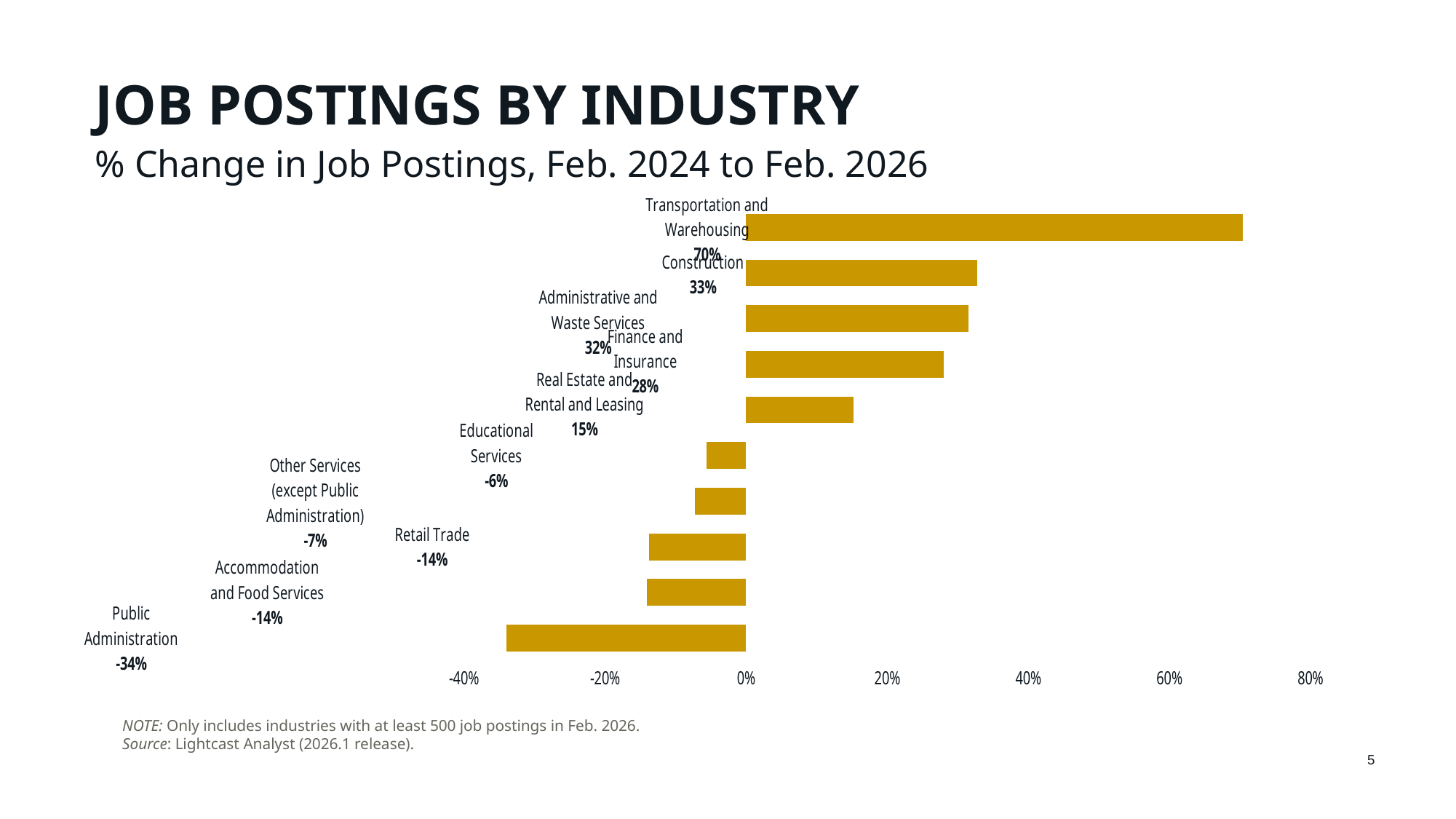
How many industries are shown in the chart? 10 What is the % change in job postings for Transportation and Warehousing? 70% Which has a larger % change in job postings, Finance and Insurance or Real Estate and Rental and Leasing? Finance and Insurance What is the % change in job postings for Construction? 33% What is the subtitle of the chart? % Change in Job Postings, Feb. 2024 to Feb. 2026 What is the % change in job postings for Retail Trade? -14% What is the difference between the % change for Transportation and Warehousing and the % change for Construction? 37 percentage points Which industry has the lowest % change in job postings? Public Administration What is the % change in job postings for Public Administration? -34% What is the % change in job postings for Real Estate and Rental and Leasing? 15% Which industry has the highest % change in job postings? Transportation and Warehousing What kind of chart is shown on the slide? Bar chart